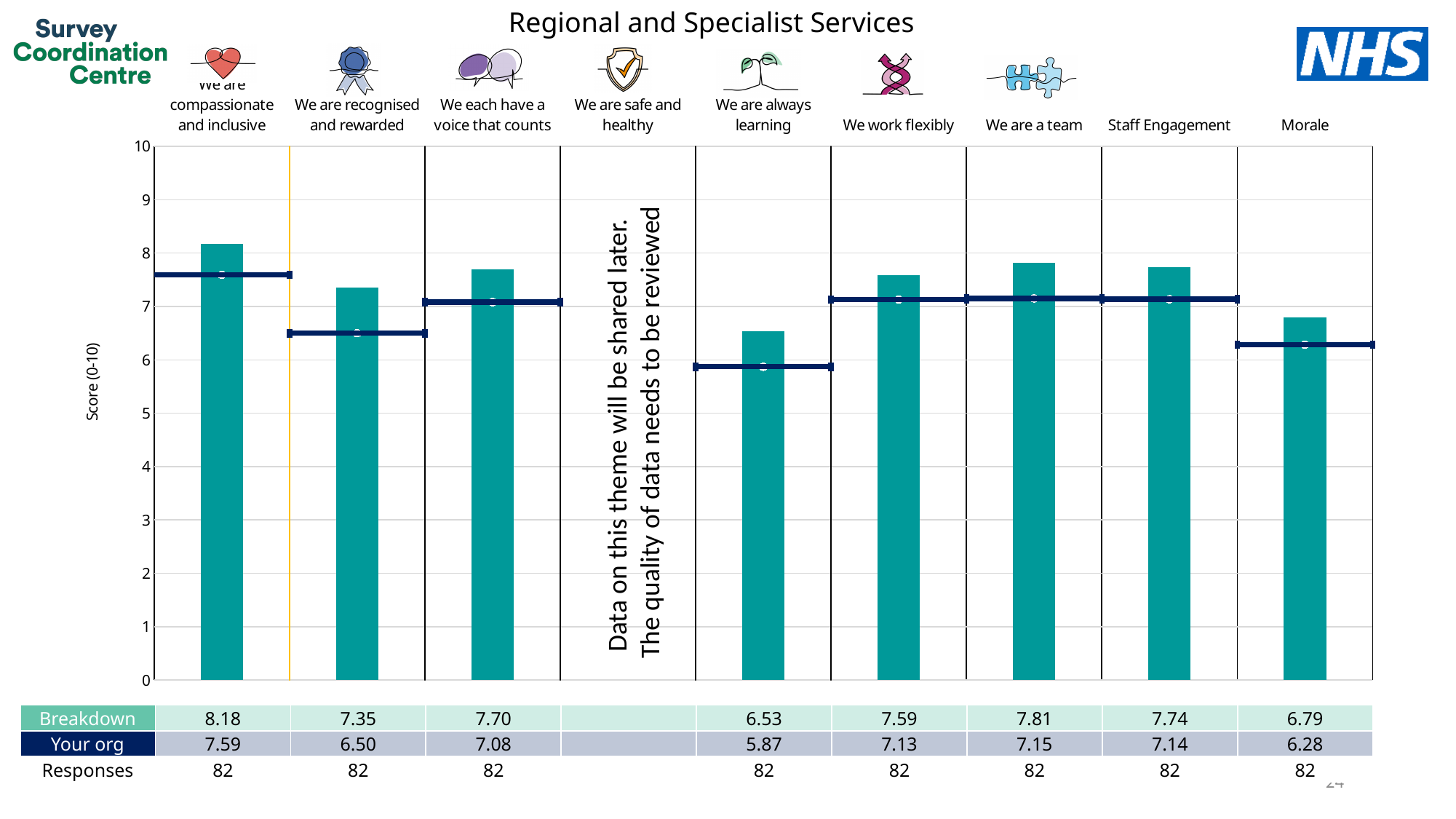
Is the Breakdown bar for 'We are always learning' greater or less than 7? less How many themes have a Breakdown score shown in the table? 8 What is the difference between the Breakdown score and the 'Your org' score for 'We are compassionate and inclusive'? 0.59 What is the Breakdown score for 'We are compassionate and inclusive'? 8.18 What is the title of the chart? Regional and Specialist Services Which theme has the lowest Breakdown score? We are always learning What is the 'Your org' score for 'We are always learning'? 5.87 What is the Breakdown score for 'Morale'? 6.79 Which theme has the highest Breakdown score? We are compassionate and inclusive Which is larger for 'We are a team': the Breakdown score or the 'Your org' score? Breakdown What kind of chart is shown on the slide? bar chart How many responses are recorded for 'Staff Engagement'? 82